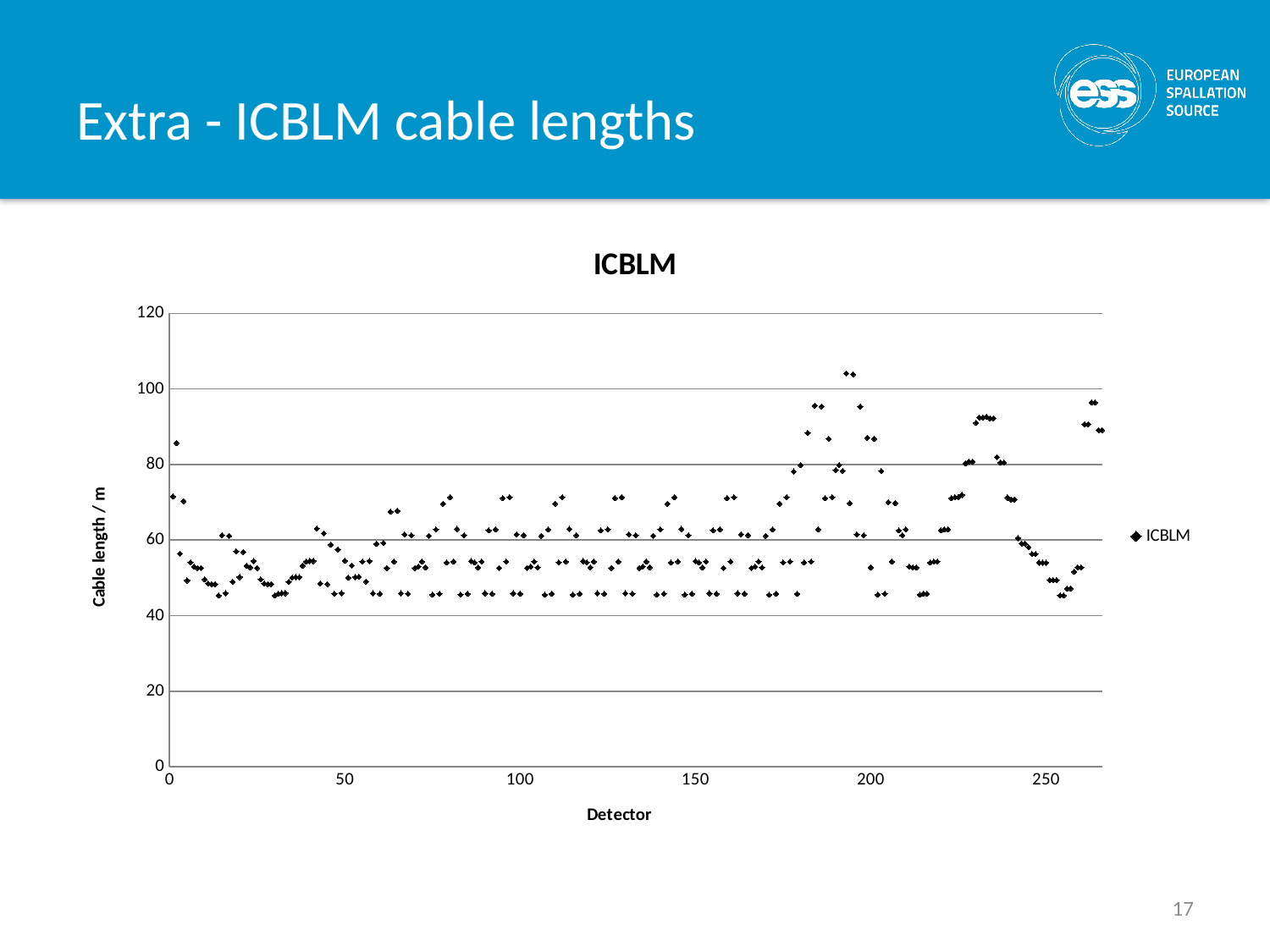
Is the lowest plotted cable length greater or less than 40? greater Is the highest plotted cable length greater or less than 120? less What is the label of the vertical axis? Cable length / m Is the highest plotted cable length greater or less than 100? greater What kind of chart is shown on the slide? scatter chart What is the title of the chart? ICBLM What is the highest value shown on the vertical axis? 120 What is the largest tick value shown on the horizontal axis? 250 How many series does the legend list? 1